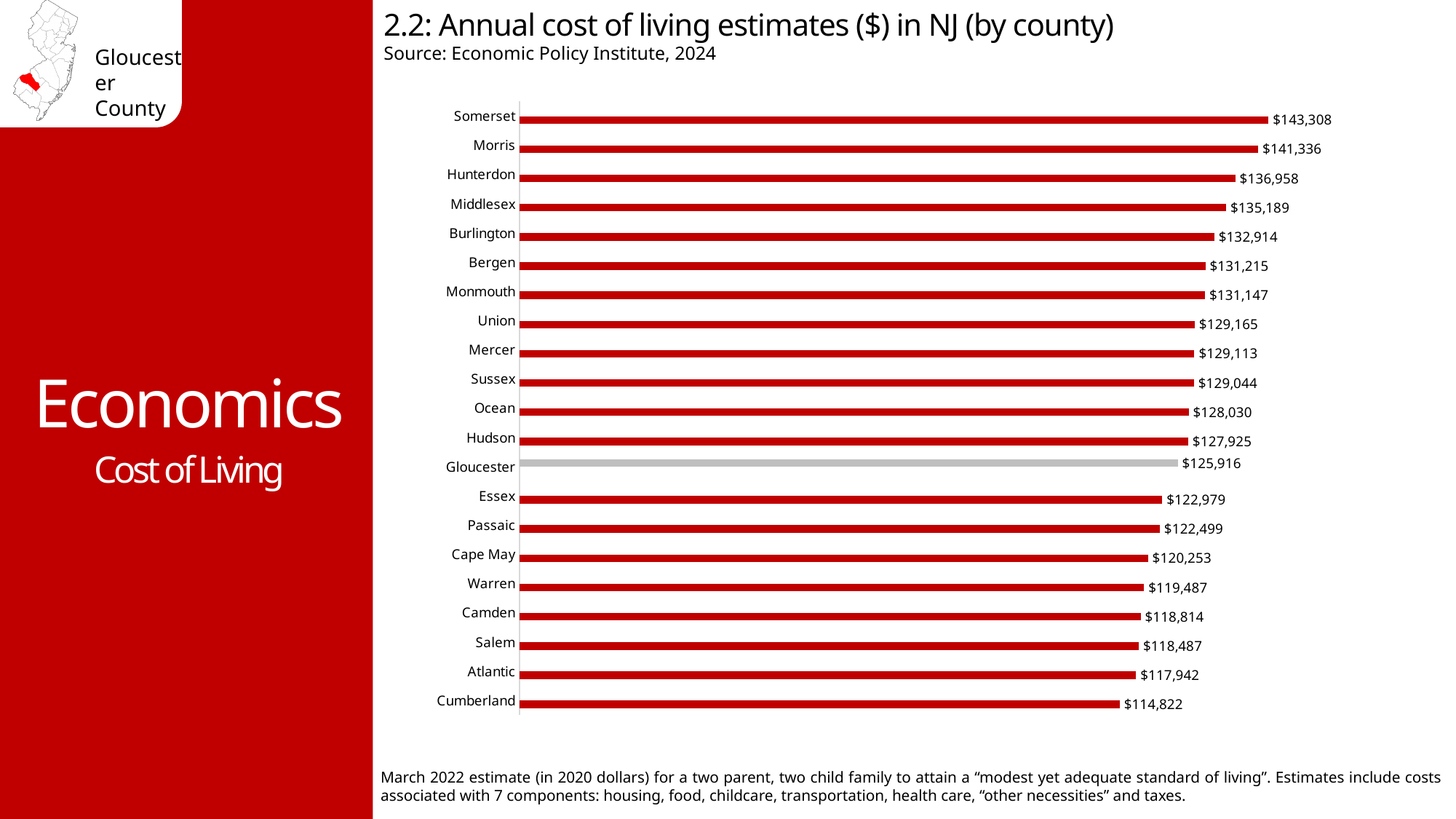
What is the difference between the cost of living estimates for Somerset and Cumberland? $28,486 What kind of chart is used to show the annual cost of living estimates? Bar chart What is the difference between the cost of living estimates for Gloucester and Camden? $7,102 Which county has the lowest annual cost of living estimate? Cumberland What is the source cited for the chart? Economic Policy Institute, 2024 Which has a higher cost of living estimate, Essex or Gloucester? Gloucester Which county has the highest annual cost of living estimate? Somerset What is the annual cost of living estimate for Bergen County? $131,215 Which county's bar is shown in grey rather than red? Gloucester Which has a higher cost of living estimate, Hunterdon or Middlesex? Hunterdon How many counties are shown in the chart? 21 What is the annual cost of living estimate for Gloucester County? $125,916